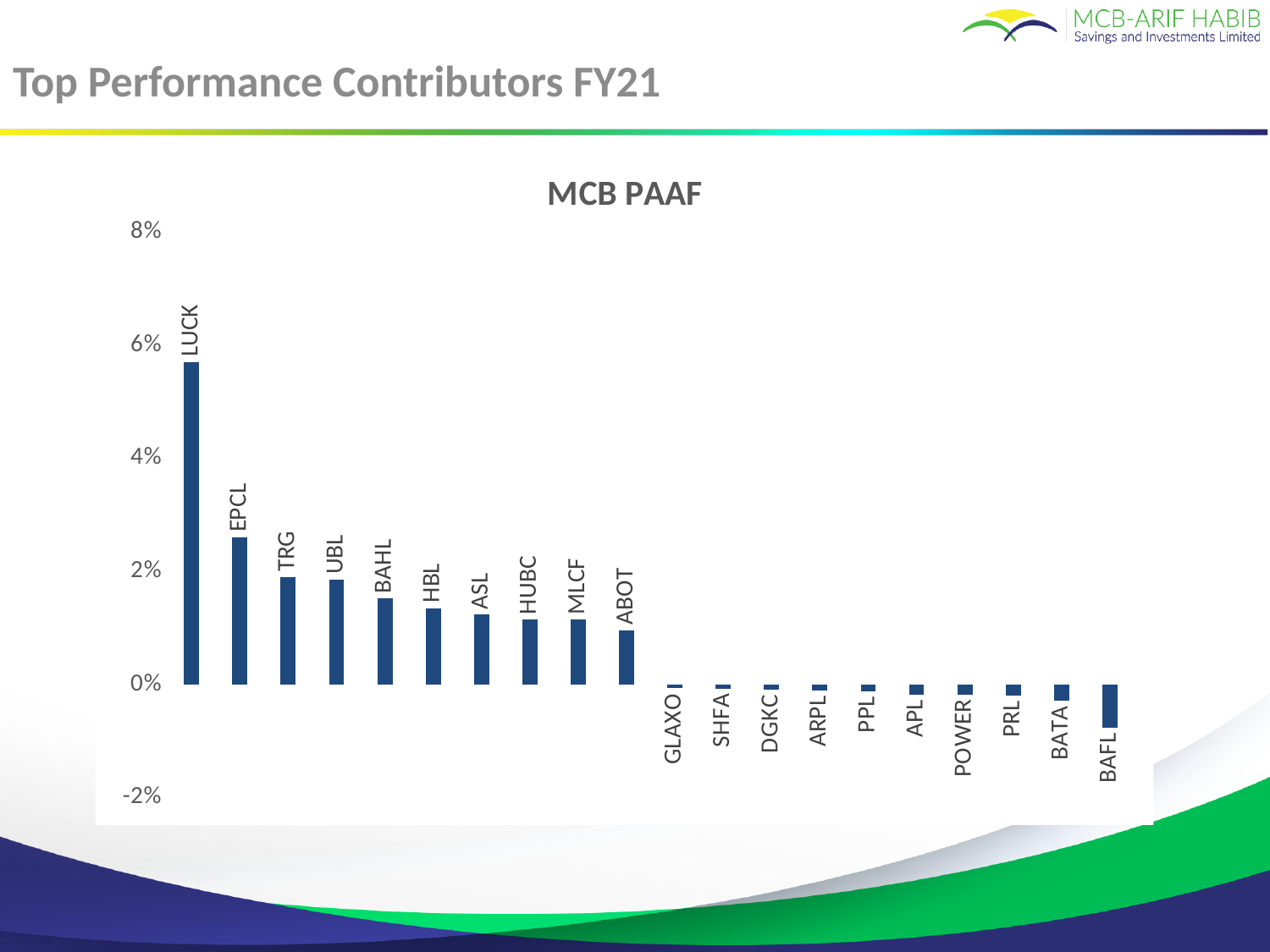
Is the value for LUCK greater or less than 4%? greater Which is larger, the value for LUCK or the value for EPCL? LUCK What is the title of the chart? MCB PAAF Is the value for BAFL greater or less than 0%? less How many categories are plotted in the chart? 20 Which category has the lowest value in the chart? BAFL What kind of chart is shown on the slide? bar chart Is the value for EPCL greater or less than 2%? greater Which category has the highest value in the chart? LUCK Do the values generally rise or fall moving from left to right along the x axis? fall Which is larger, the value for BAHL or the value for ABOT? BAHL